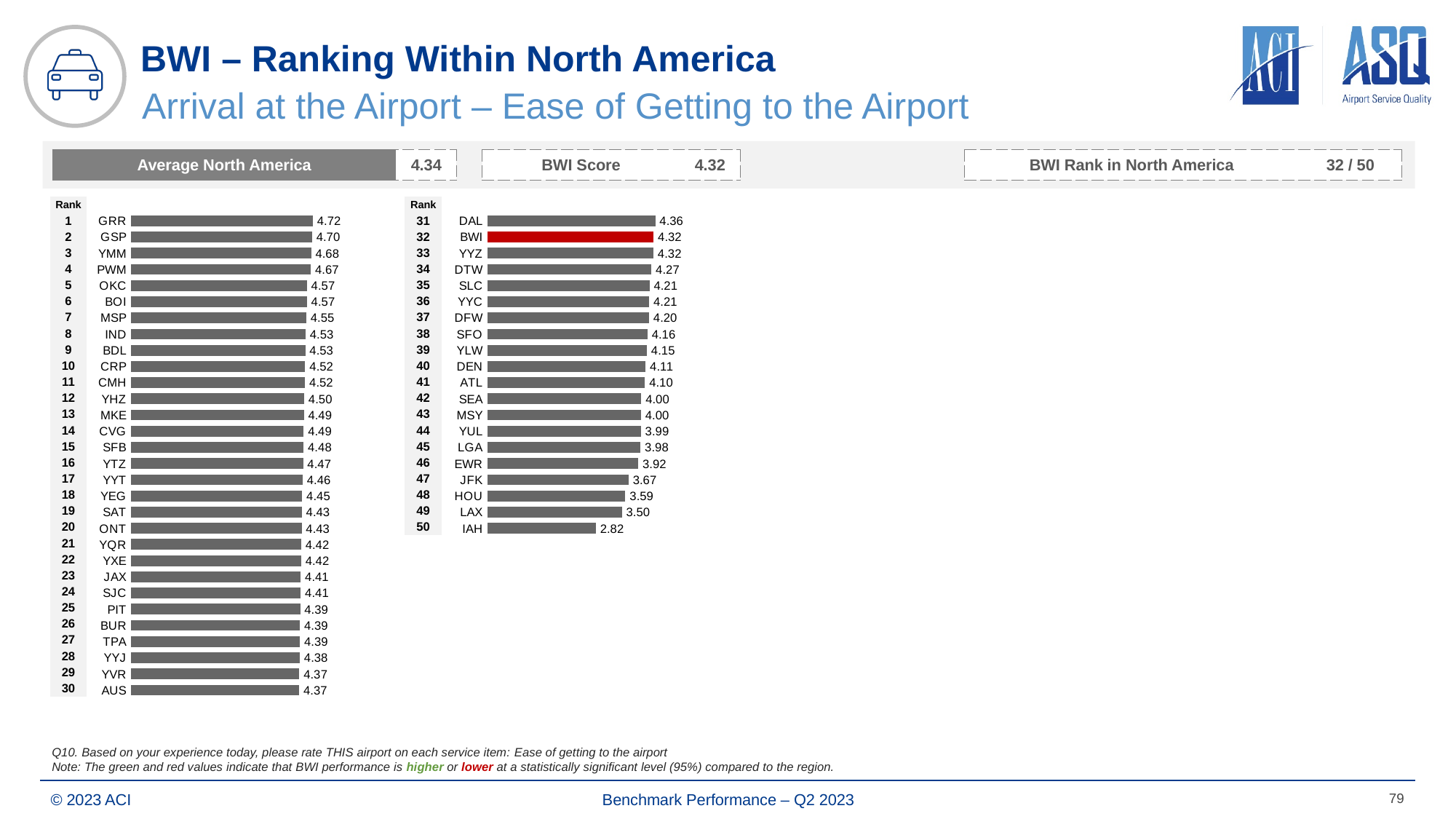
How many airports are shown in the left chart (ranks 1–30)? 30 In the right chart (ranks 31–50), which bar is highlighted in red? BWI What type of chart is used to show the airport scores? Bar chart Which airport has the highest score in the left chart (ranks 1–30)? GRR What is the score for IAH in the right chart (ranks 31–50)? 2.82 What is the score for BWI in the right chart (ranks 31–50)? 4.32 How many airports are shown in the right chart (ranks 31–50)? 20 What is the difference between the Average North America score and the BWI Score shown at the top of the slide? 0.02 In the right chart (ranks 31–50), which has the larger score, JFK or LAX? JFK Which airport has the lowest score in the right chart (ranks 31–50)? IAH What is the score for GRR in the left chart (ranks 1–30)? 4.72 What is the difference between the scores of GRR and IAH across the two charts? 1.90